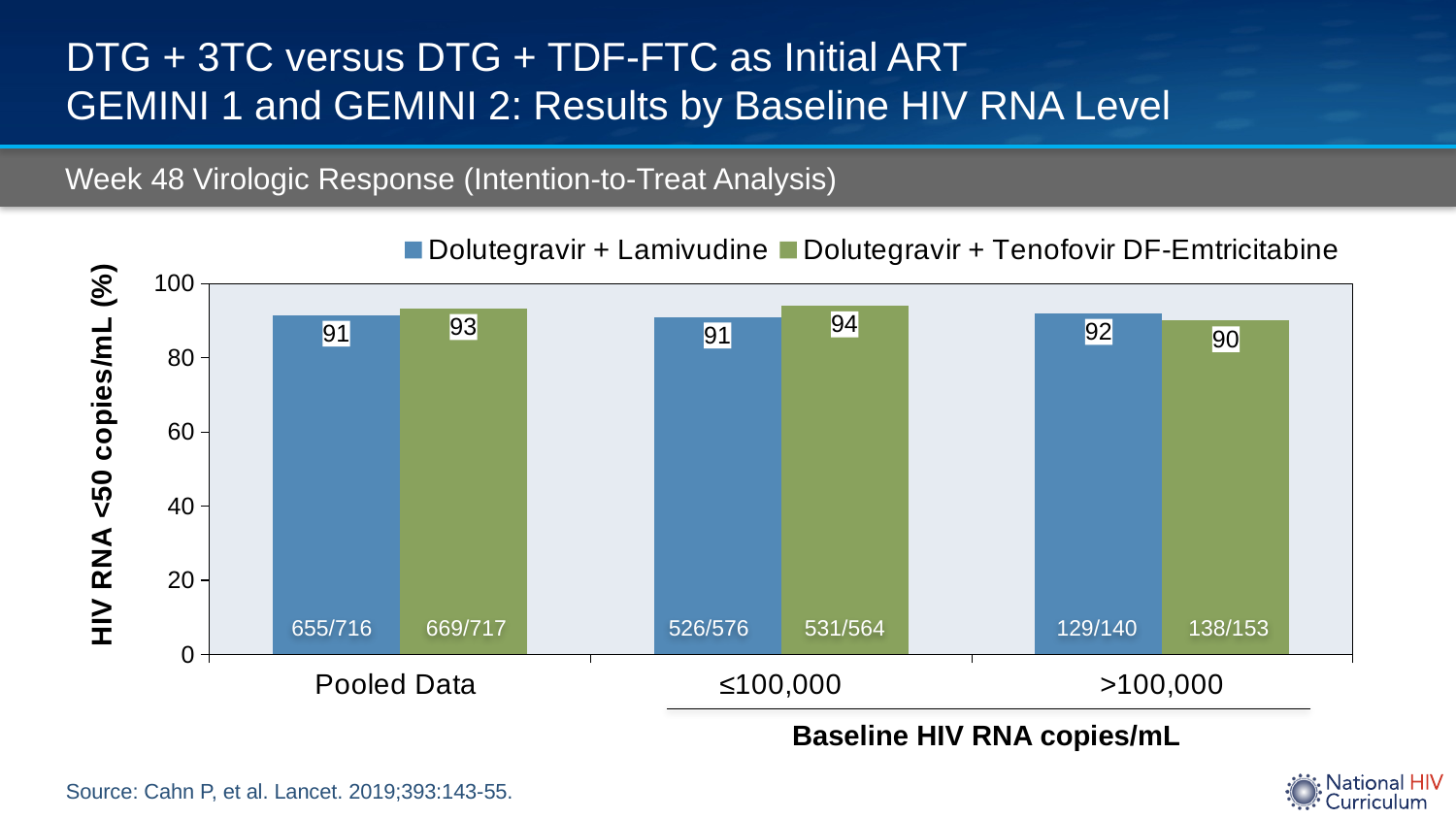
What is the difference between the two series in the Pooled Data category? 2 What is the label of the y axis? HIV RNA <50 copies/mL (%) What is the value for Dolutegravir + Lamivudine in the Pooled Data category? 91 What is the value for Dolutegravir + Tenofovir DF-Emtricitabine in the >100,000 category? 90 What kind of chart is shown on the slide? Bar chart Which category has the highest value for Dolutegravir + Tenofovir DF-Emtricitabine? ≤100,000 In the >100,000 category, which series has the larger value? Dolutegravir + Lamivudine What is the value for Dolutegravir + Tenofovir DF-Emtricitabine in the ≤100,000 category? 94 How many categories are shown on the x axis? 3 What is the value for Dolutegravir + Lamivudine in the >100,000 category? 92 What is the difference between the two series in the ≤100,000 category? 3 How many series does the legend list? 2